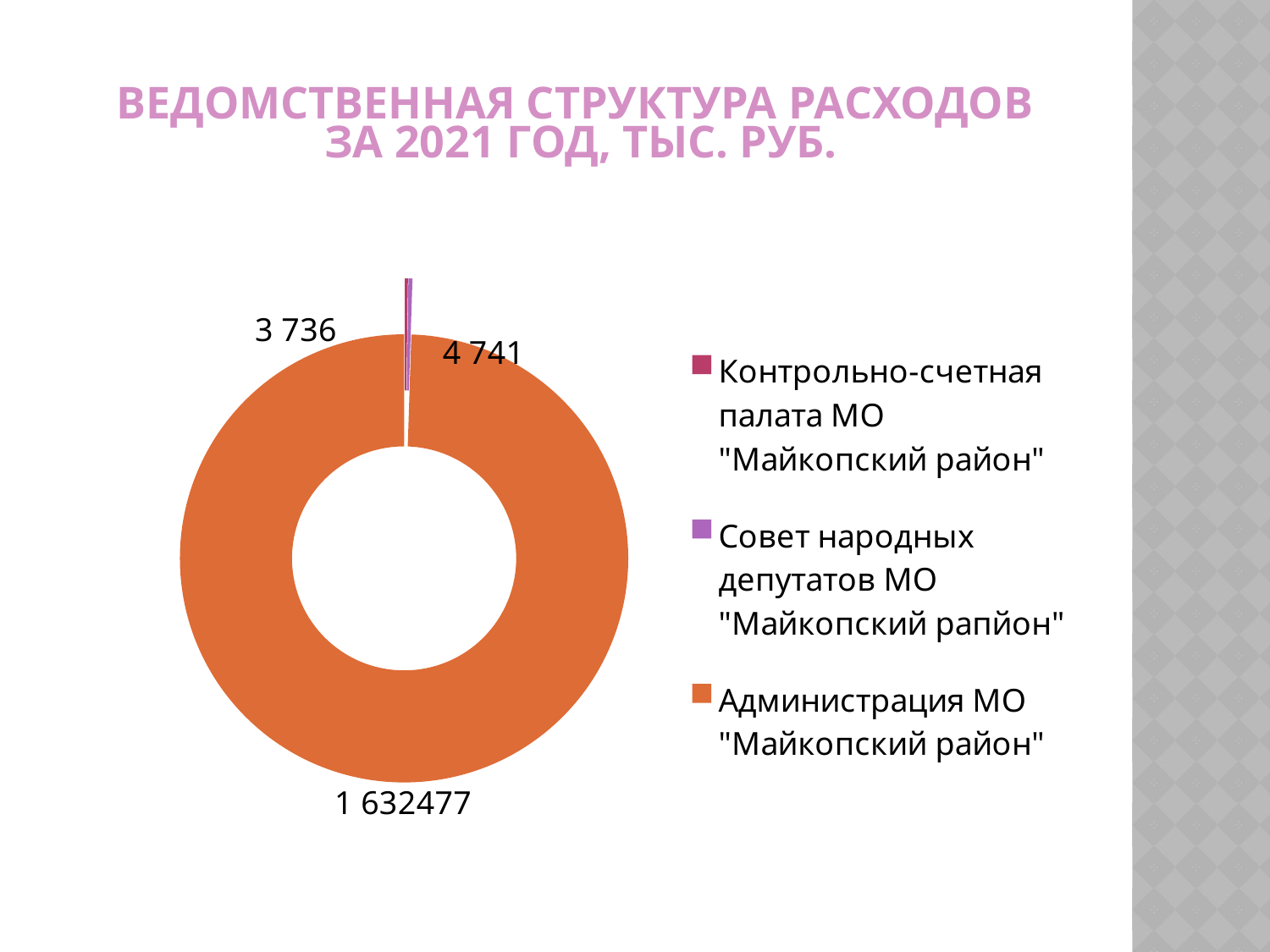
What is the smallest value shown on the chart? 3 736 What is the largest value shown on the chart? 1 632477 How many entries does the legend list? 3 Which is larger: the value for Администрация МО "Майкопский район" or the value for Совет народных депутатов МО "Майкопский рапйон"? Администрация МО "Майкопский район" How many categories does the chart show? 3 What is the value for Администрация МО "Майкопский район"? 1 632477 What kind of chart is shown on the slide? Doughnut (pie) chart What is the total of all three values shown on the chart? 1 640 954 What is the difference between the two smallest values shown, 4 741 and 3 736? 1 005 Which category has the largest value? Администрация МО "Майкопский район" What colour represents Администрация МО "Майкопский район" in the chart? Orange What is the title of the chart? ВЕДОМСТВЕННАЯ СТРУКТУРА РАСХОДОВ ЗА 2021 ГОД, ТЫС. РУБ.